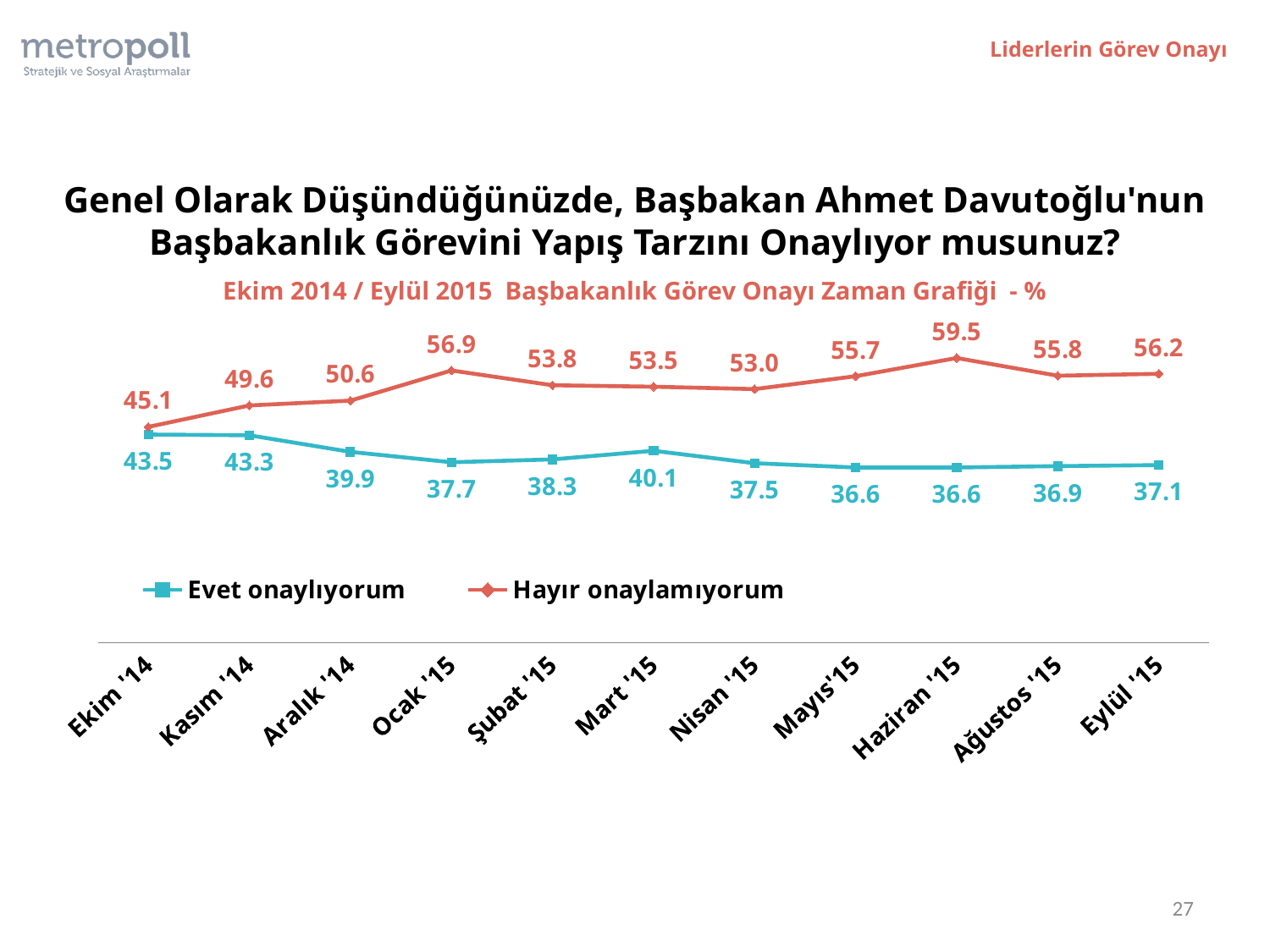
What is the value for 'Hayır onaylamıyorum' in Haziran '15? 59.5 In which month does 'Hayır onaylamıyorum' reach its highest value? Haziran '15 How many time points are plotted on the x axis? 11 In which month does 'Hayır onaylamıyorum' have its lowest value? Ekim '14 What is the value for 'Evet onaylıyorum' in Ekim '14? 43.5 What is the value for 'Evet onaylıyorum' in Mart '15? 40.1 Which is larger in Ocak '15: 'Evet onaylıyorum' or 'Hayır onaylamıyorum'? Hayır onaylamıyorum What kind of chart is shown on the slide? line chart Does 'Evet onaylıyorum' generally rise or fall from Ekim '14 to Eylül '15? fall What is the difference between 'Hayır onaylamıyorum' and 'Evet onaylıyorum' in Eylül '15? 19.1 How many series does the legend list? 2 What is the subtitle of the chart? Ekim 2014 / Eylül 2015 Başbakanlık Görev Onayı Zaman Grafiği - %